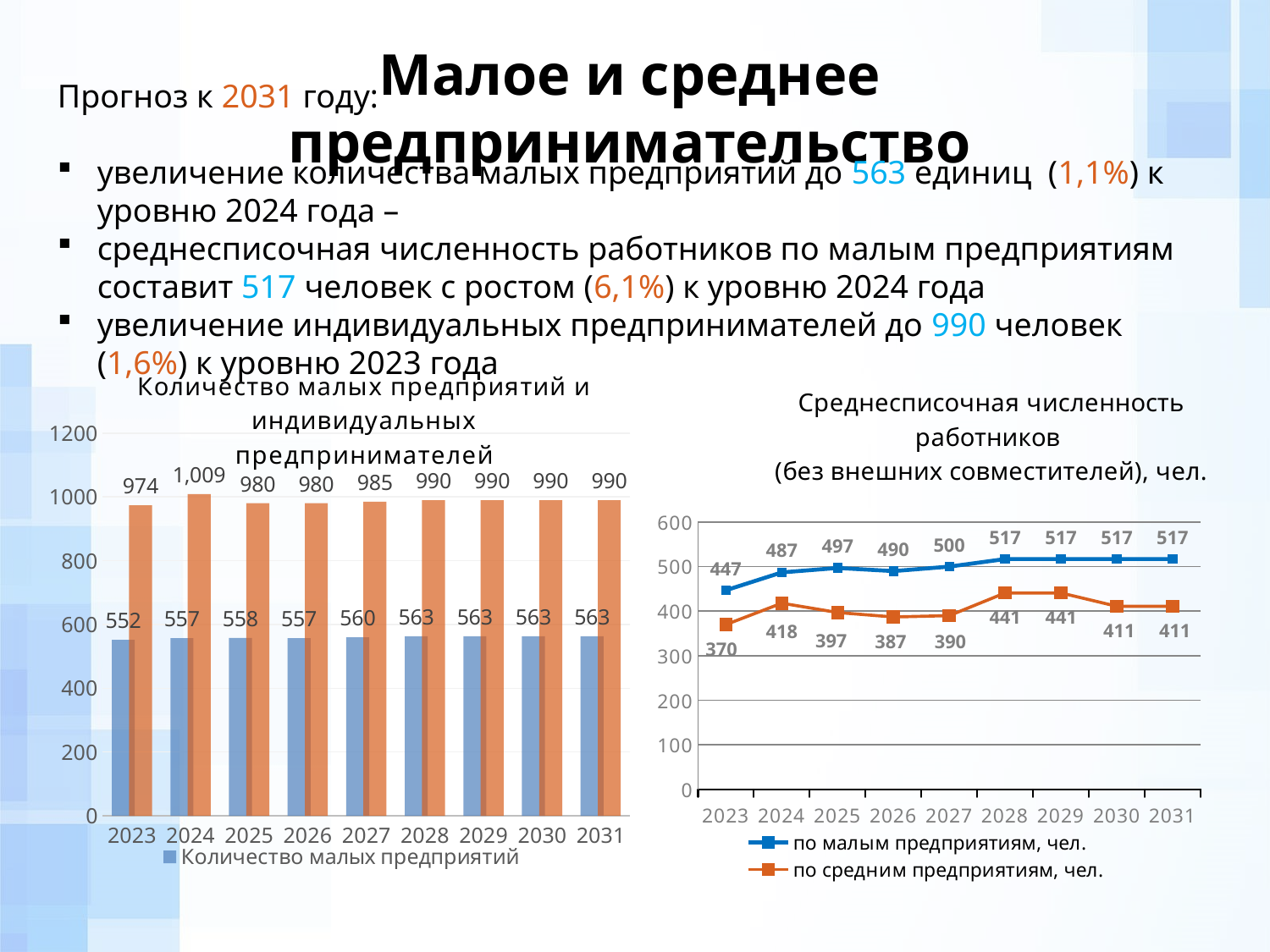
In the chart 'Среднесписочная численность работников', what is the value for 'по средним предприятиям, чел.' in 2023? 370 In the left chart, what is the value of 'Количество малых предприятий' for 2023? 552 What kind of chart is the chart 'Среднесписочная численность работников'? line chart In the left chart, what is the value of the orange bar for 2024? 1,009 What kind of chart is the left chart? bar chart How many series does the legend of the chart 'Среднесписочная численность работников' list? 2 In the chart 'Среднесписочная численность работников', what is the difference between 'по малым предприятиям, чел.' and 'по средним предприятиям, чел.' in 2028? 76 In the chart 'Среднесписочная численность работников', which year has the lowest value for 'по средним предприятиям, чел.'? 2023 In the left chart, which year has the highest orange bar? 2024 In the chart 'Среднесписочная численность работников', what is the value for 'по малым предприятиям, чел.' in 2027? 500 In the left chart, which year has the lowest value for 'Количество малых предприятий'? 2023 In the left chart, what is the difference between the orange bar and the blue bar for 2031? 427